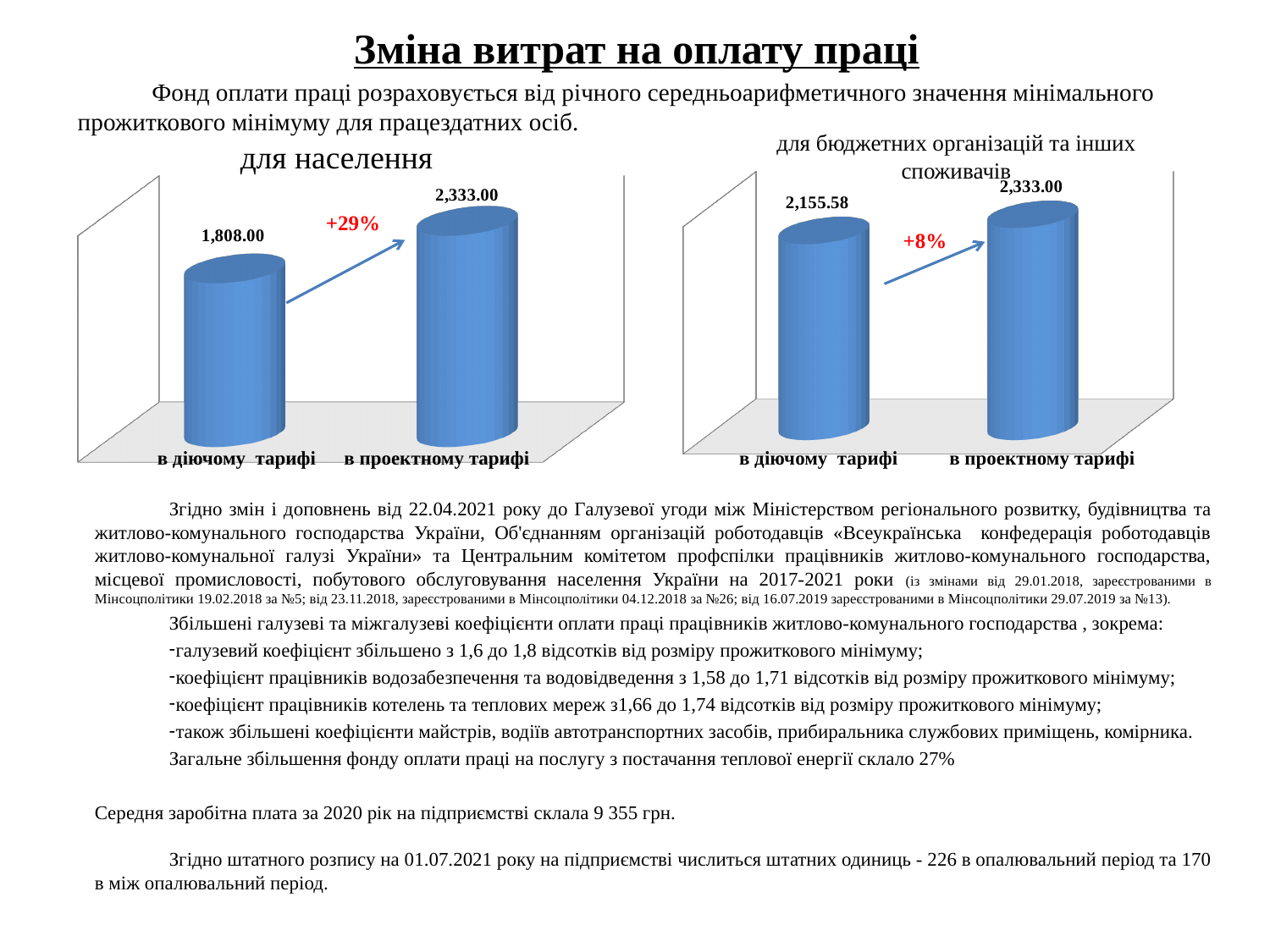
In the chart titled 'для бюджетних організацій та інших споживачів', which category has the lower value? в діючому тарифі How many categories are shown in the chart titled 'для населення'? 2 In the chart titled 'для бюджетних організацій та інших споживачів', what is the difference between the value for 'в проектному тарифі' and the value for 'в діючому тарифі'? 177.42 In the chart titled 'для населення', what is the value for 'в проектному тарифі'? 2,333.00 In the chart titled 'для бюджетних організацій та інших споживачів', what is the value for 'в проектному тарифі'? 2,333.00 In the chart titled 'для населення', what is the difference between the value for 'в проектному тарифі' and the value for 'в діючому тарифі'? 525.00 In the chart titled 'для населення', which category has the higher value? в проектному тарифі What kind of chart is the chart titled 'для населення'? bar chart In the chart titled 'для бюджетних організацій та інших споживачів', what is the value for 'в діючому тарифі'? 2,155.58 Is the value for 'в діючому тарифі' larger in the left chart ('для населення') or in the right chart ('для бюджетних організацій та інших споживачів')? right chart In the chart titled 'для населення', what is the value for 'в діючому тарифі'? 1,808.00 What percentage increase is annotated on the chart titled 'для бюджетних організацій та інших споживачів'? +8%